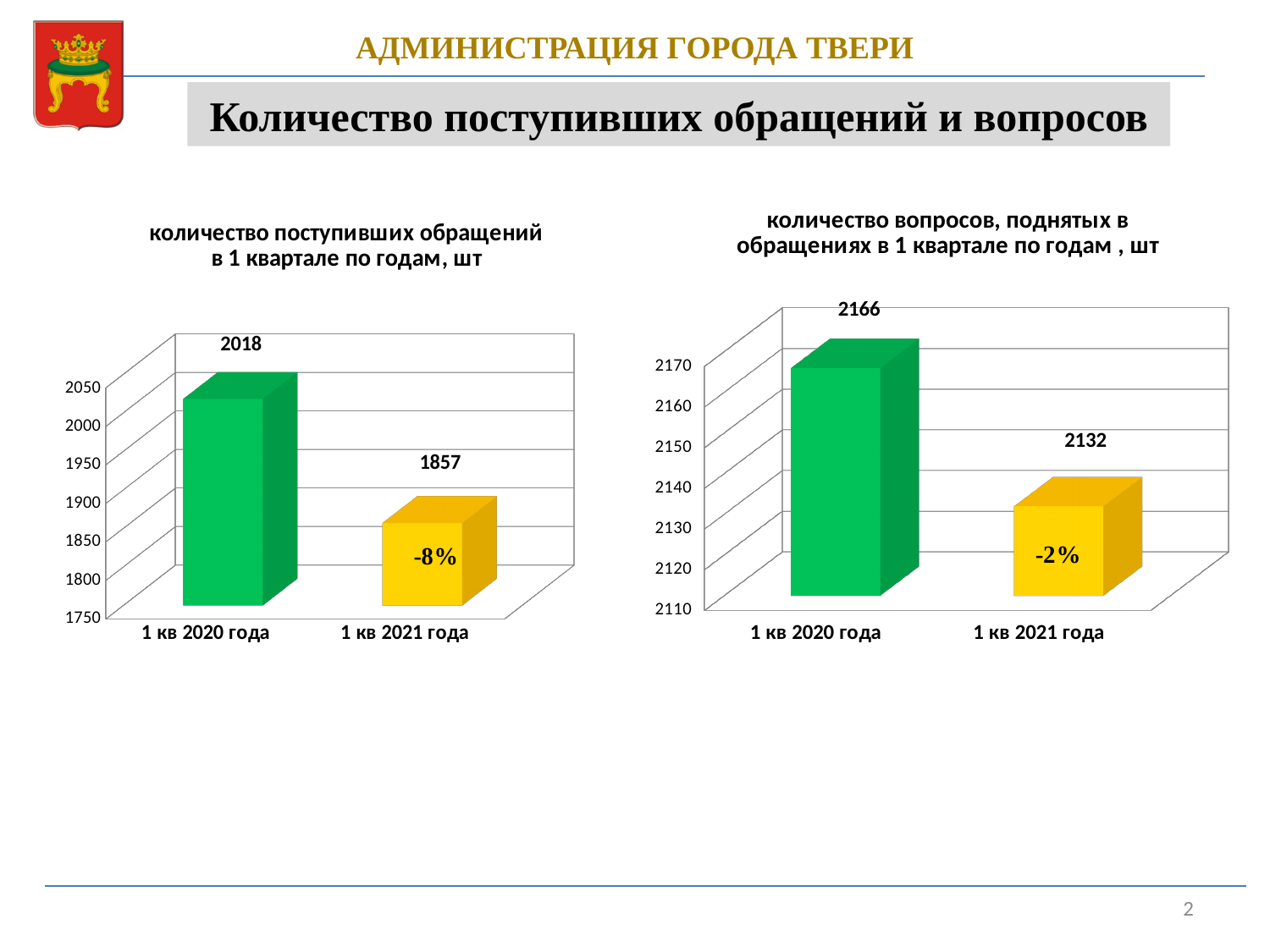
In the right chart (количество вопросов, поднятых в обращениях в 1 квартале по годам, шт), what is the value for 1 кв 2021 года? 2132 In the right chart (количество вопросов, поднятых в обращениях в 1 квартале по годам, шт), what is the value for 1 кв 2020 года? 2166 In the right chart, which category has the lowest value? 1 кв 2021 года In the left chart, which category has the highest value? 1 кв 2020 года In the left chart (количество поступивших обращений в 1 квартале по годам, шт), what is the value for 1 кв 2020 года? 2018 In the right chart, which is larger: the value for 1 кв 2020 года or 1 кв 2021 года? 1 кв 2020 года How many categories are shown in the left chart? 2 What kind of chart is the right chart? bar chart In the left chart (количество поступивших обращений в 1 квартале по годам, шт), what is the value for 1 кв 2021 года? 1857 In the left chart, what is the difference between the values for 1 кв 2020 года and 1 кв 2021 года? 161 In the right chart, what is the difference between the values for 1 кв 2020 года and 1 кв 2021 года? 34 In the left chart, what percentage change label is printed on the bar for 1 кв 2021 года? -8%